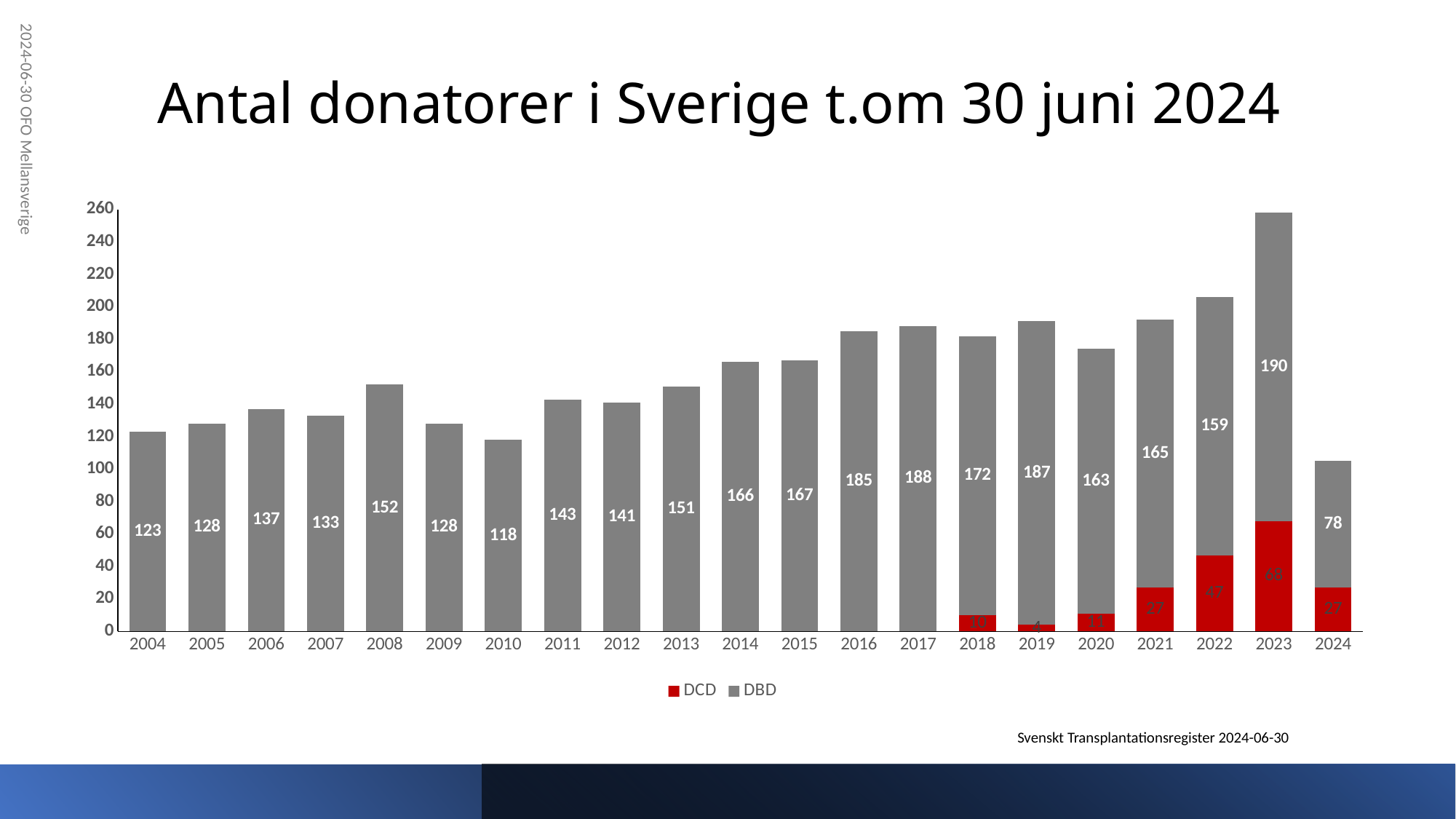
Which year has the highest DBD value? 2023 Which is larger, the DBD value for 2014 or for 2011? 2014 Which year has the lowest DBD value? 2024 What is the DBD value for 2016? 185 How many years are shown on the x axis? 21 What is the DBD value for 2010? 118 What is the total of the stacked bar for 2023? 258 What is the DCD value for 2023? 68 Is the total of the stacked bar for 2022 greater or less than 200? greater What is the difference between the DBD values for 2017 and 2016? 3 What kind of chart is shown on the slide? Stacked bar chart How many series does the legend list? 2